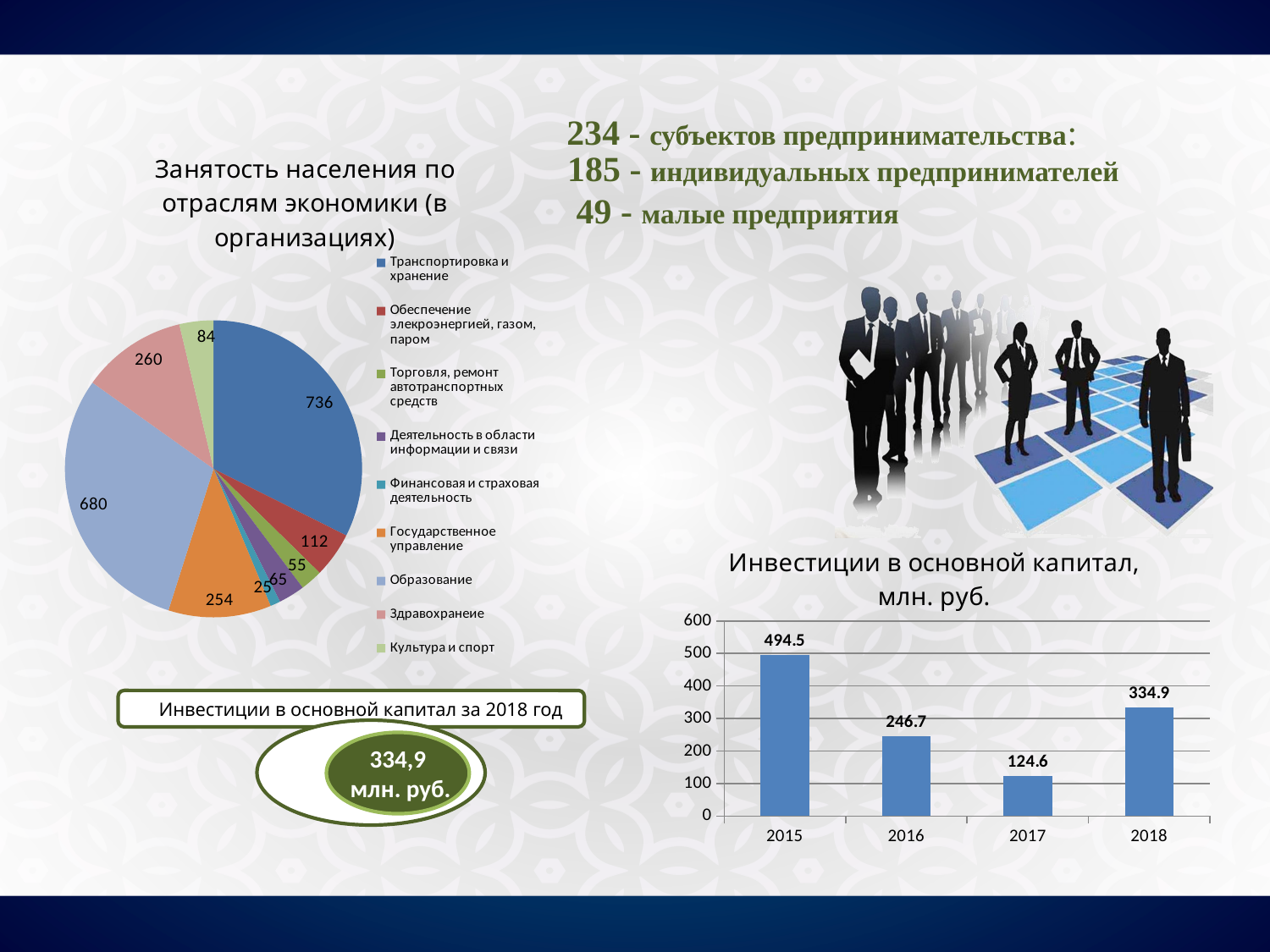
How many categories does the pie chart 'Занятость населения по отраслям экономики (в организациях)' show? 9 In the pie chart 'Занятость населения по отраслям экономики (в организациях)', which category has the largest slice? Транспортировка и хранение In the 'Инвестиции в основной капитал, млн. руб.' chart, what is the value for 2015? 494.5 What kind of chart is the 'Инвестиции в основной капитал, млн. руб.' chart? bar chart How many bars are in the 'Инвестиции в основной капитал, млн. руб.' chart? 4 In the pie chart 'Занятость населения по отраслям экономики (в организациях)', which category has the smallest slice? Финансовая и страховая деятельность In the 'Инвестиции в основной капитал, млн. руб.' chart, which year has the lowest value? 2017 In the 'Инвестиции в основной капитал, млн. руб.' chart, which year has the highest value? 2015 In the pie chart 'Занятость населения по отраслям экономики (в организациях)', what is the value for Здравохранеие? 260 In the 'Инвестиции в основной капитал, млн. руб.' chart, what is the difference between the values for 2018 and 2017? 210.3 In the 'Инвестиции в основной капитал, млн. руб.' chart, which is larger, the value for 2016 or the value for 2018? 2018 In the pie chart 'Занятость населения по отраслям экономики (в организациях)', what is the value for Образование? 680